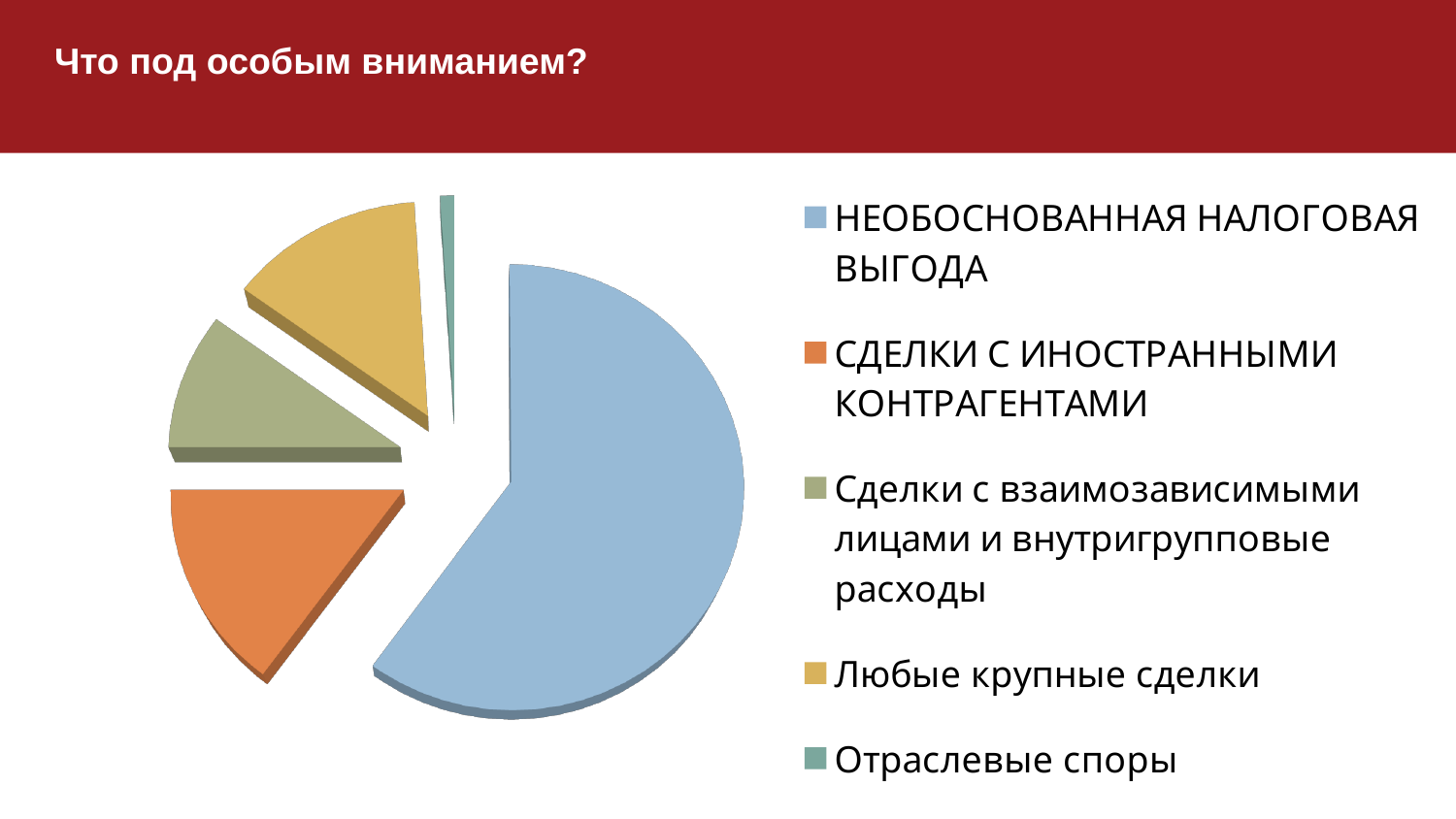
Which category is shown in light blue in the pie chart? НЕОБОСНОВАННАЯ НАЛОГОВАЯ ВЫГОДА Which slice is larger: Сделки с взаимозависимыми лицами и внутригрупповые расходы or Отраслевые споры? Сделки с взаимозависимыми лицами и внутригрупповые расходы Which category has the largest slice in the pie chart? НЕОБОСНОВАННАЯ НАЛОГОВАЯ ВЫГОДА Which slice is larger: НЕОБОСНОВАННАЯ НАЛОГОВАЯ ВЫГОДА or Любые крупные сделки? НЕОБОСНОВАННАЯ НАЛОГОВАЯ ВЫГОДА What kind of chart is shown on the slide? pie chart How many entries does the legend of the pie chart list? 5 Which slice is larger: НЕОБОСНОВАННАЯ НАЛОГОВАЯ ВЫГОДА or СДЕЛКИ С ИНОСТРАННЫМИ КОНТРАГЕНТАМИ? НЕОБОСНОВАННАЯ НАЛОГОВАЯ ВЫГОДА What colour is the slice for СДЕЛКИ С ИНОСТРАННЫМИ КОНТРАГЕНТАМИ? orange Which category has the smallest slice in the pie chart? Отраслевые споры How many slices does the pie chart have? 5